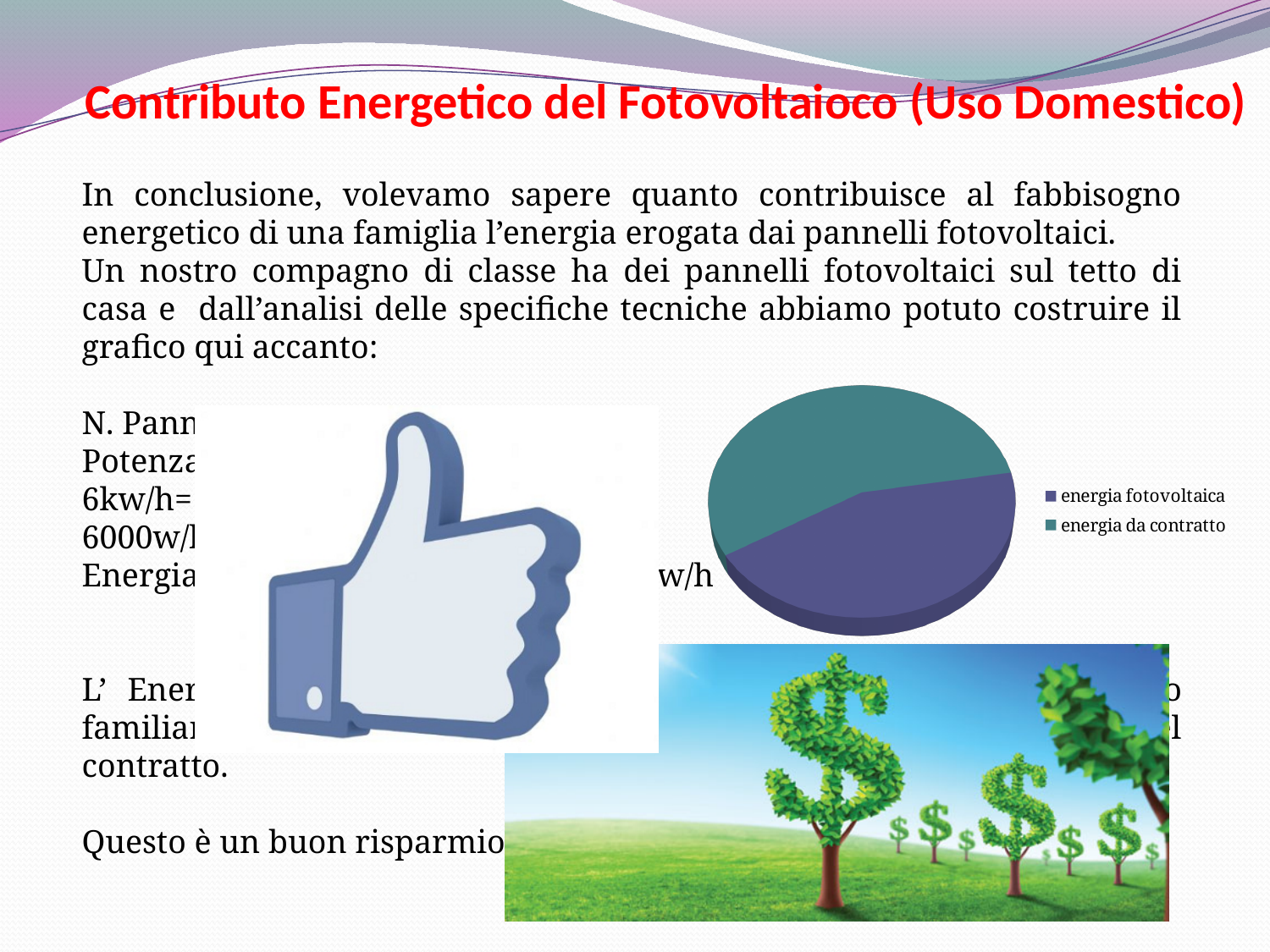
Which slice of the pie chart is the smallest? energia fotovoltaica How many entries does the legend of the pie chart list? 2 Which is larger in the pie chart, energia fotovoltaica or energia da contratto? energia da contratto Which slice of the pie chart is the largest? energia da contratto How many slices does the pie chart have? 2 Which legend entry is shown in teal/green in the pie chart? energia da contratto What kind of chart is shown on the slide? pie chart What colour is the energia fotovoltaica slice in the pie chart? purple